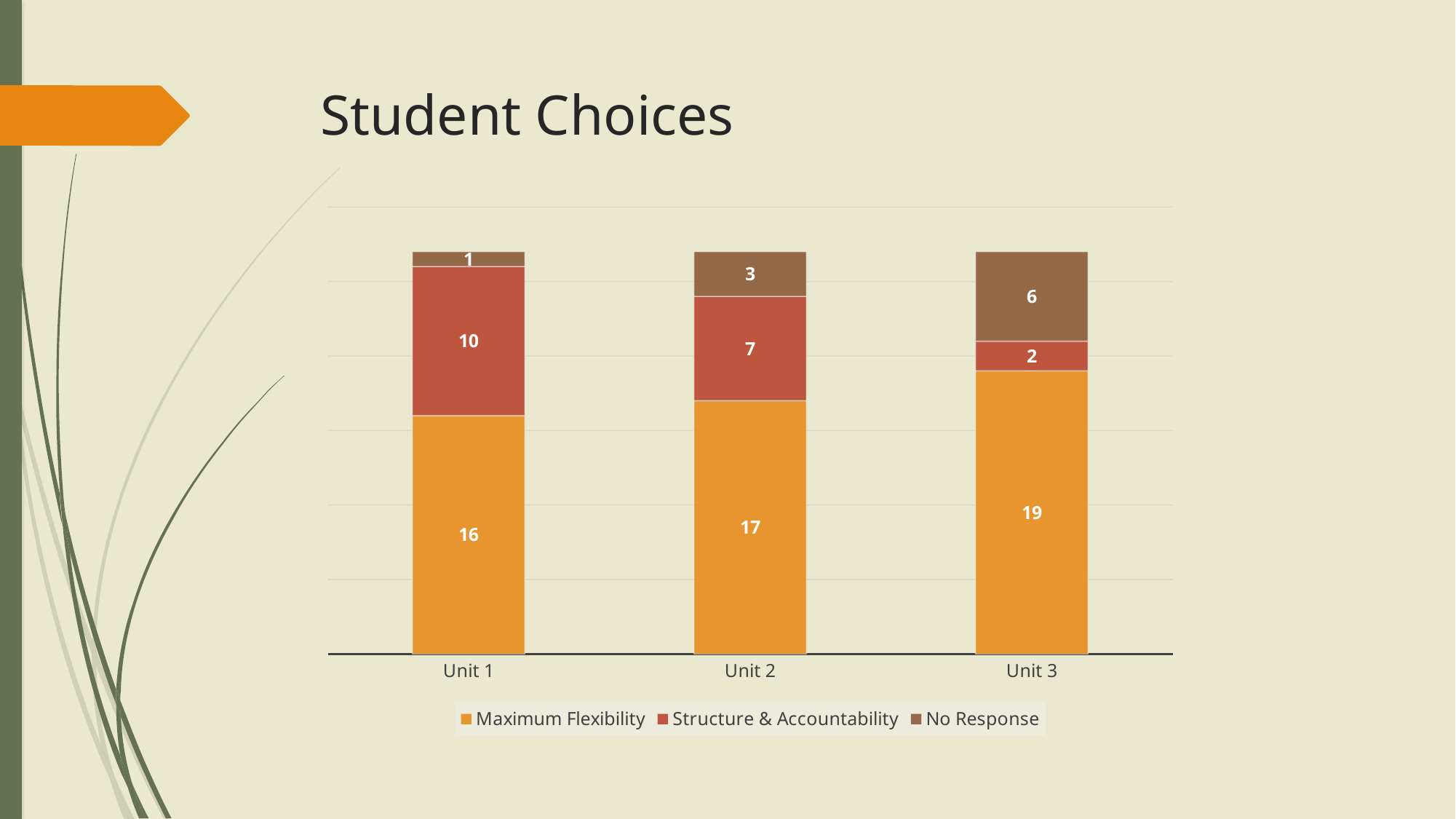
Which unit has the highest Maximum Flexibility value? Unit 3 How many units are shown on the x axis? 3 What kind of chart is shown on the slide? Stacked bar chart What is the total of the stacked bar for Unit 2? 27 What is the Maximum Flexibility value for Unit 1? 16 What is the Structure & Accountability value for Unit 2? 7 Which unit has the lowest Structure & Accountability value? Unit 3 What is the total of the stacked bar for Unit 1? 27 Which is larger, the No Response value for Unit 2 or for Unit 3? Unit 3 What is the No Response value for Unit 3? 6 How many series does the legend list? 3 What is the difference between the Structure & Accountability values for Unit 1 and Unit 3? 8